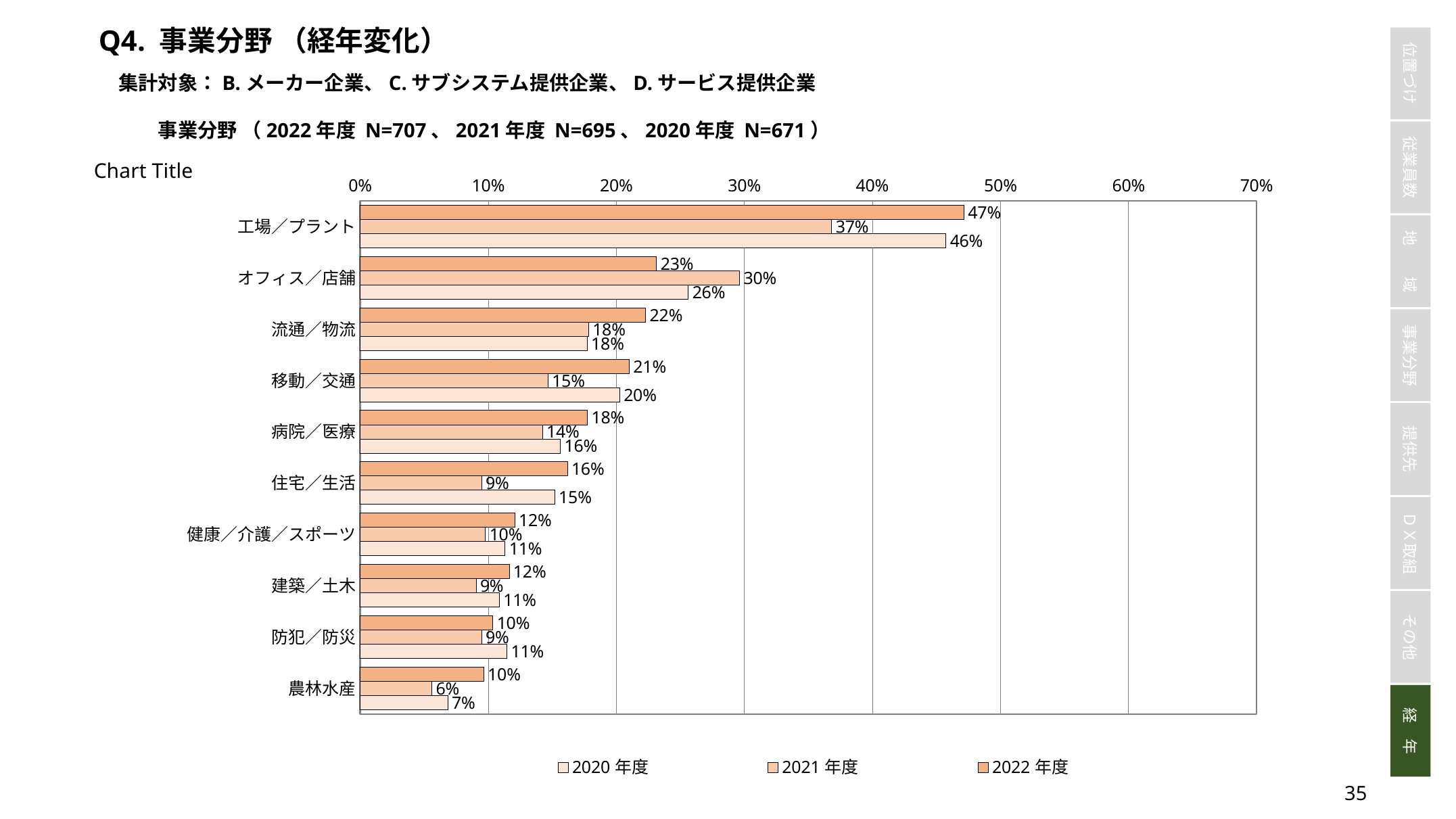
Is the 2020年度 value for 工場／プラント greater or less than 40%? greater How many series does the legend list? 3 What is the value for 農林水産 in the 2020年度 series? 7% Which category has the lowest value in the 2021年度 series? 農林水産 What kind of chart is shown on the slide? Bar chart How many categories are shown on the chart? 10 What is the value for 工場／プラント in the 2022年度 series? 47% What is the maximum value shown on the percentage axis? 70% What is the difference between the 2022年度 and 2021年度 values for 工場／プラント? 10% For 住宅／生活, which is larger: the 2022年度 value or the 2021年度 value? 2022年度 Which category has the highest value in the 2022年度 series? 工場／プラント What is the value for オフィス／店舗 in the 2021年度 series? 30%